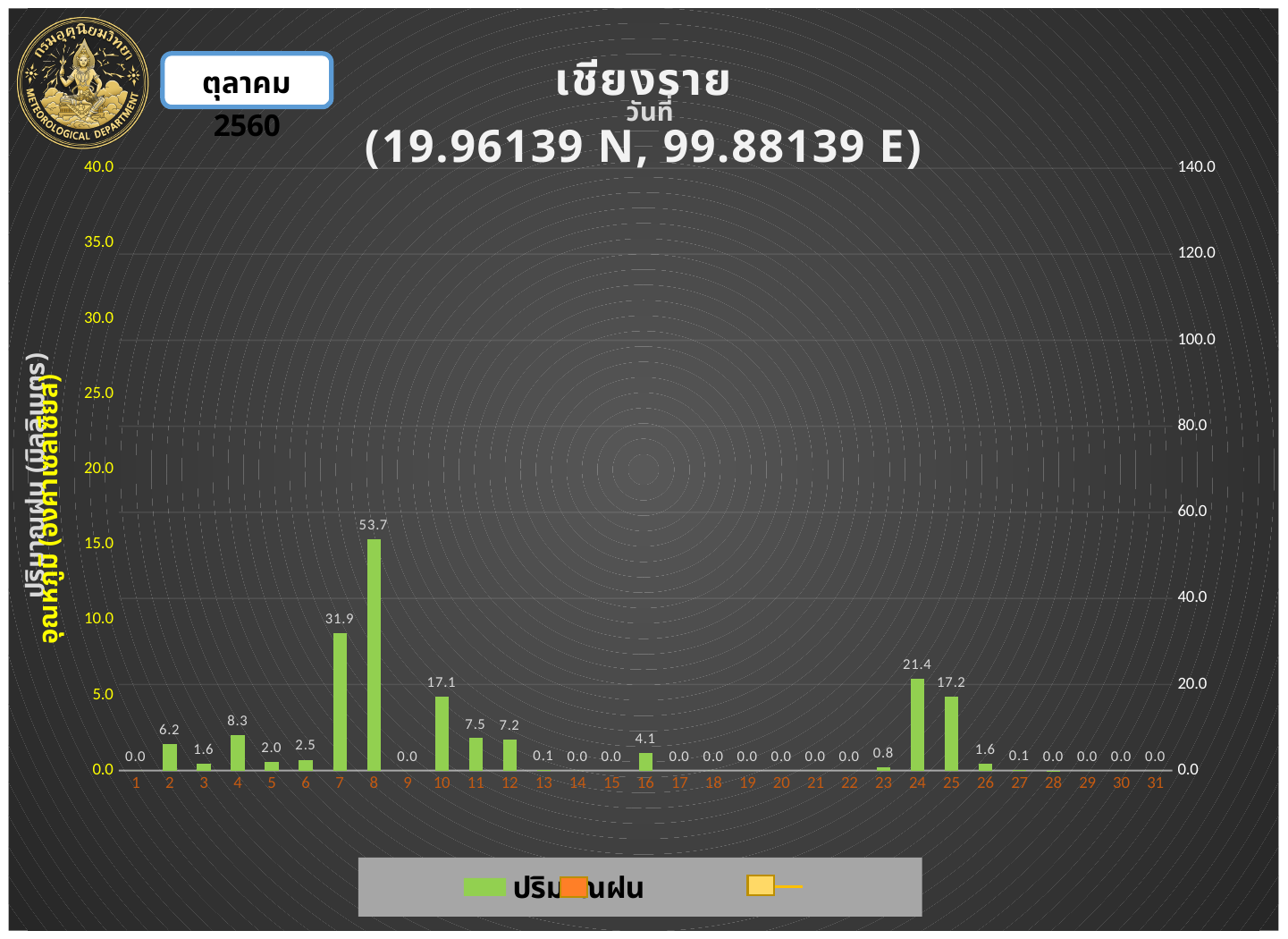
What coordinates are given in the chart title? 19.96139 N, 99.88139 E What is the rainfall value shown for day 10? 17.1 What is the rainfall value shown for day 13? 0.1 What is the difference between the rainfall values for day 8 and day 7? 21.8 Which is larger, the rainfall value for day 11 or for day 16? day 11 What is the rainfall value shown for day 24? 21.4 What is the rainfall value shown for day 8? 53.7 Which is larger, the rainfall value for day 4 or for day 2? day 4 How many days are shown on the x axis? 31 Which day has the highest rainfall value? 8 What kind of chart is shown on the slide? bar chart What is the difference between the rainfall values for day 24 and day 25? 4.2